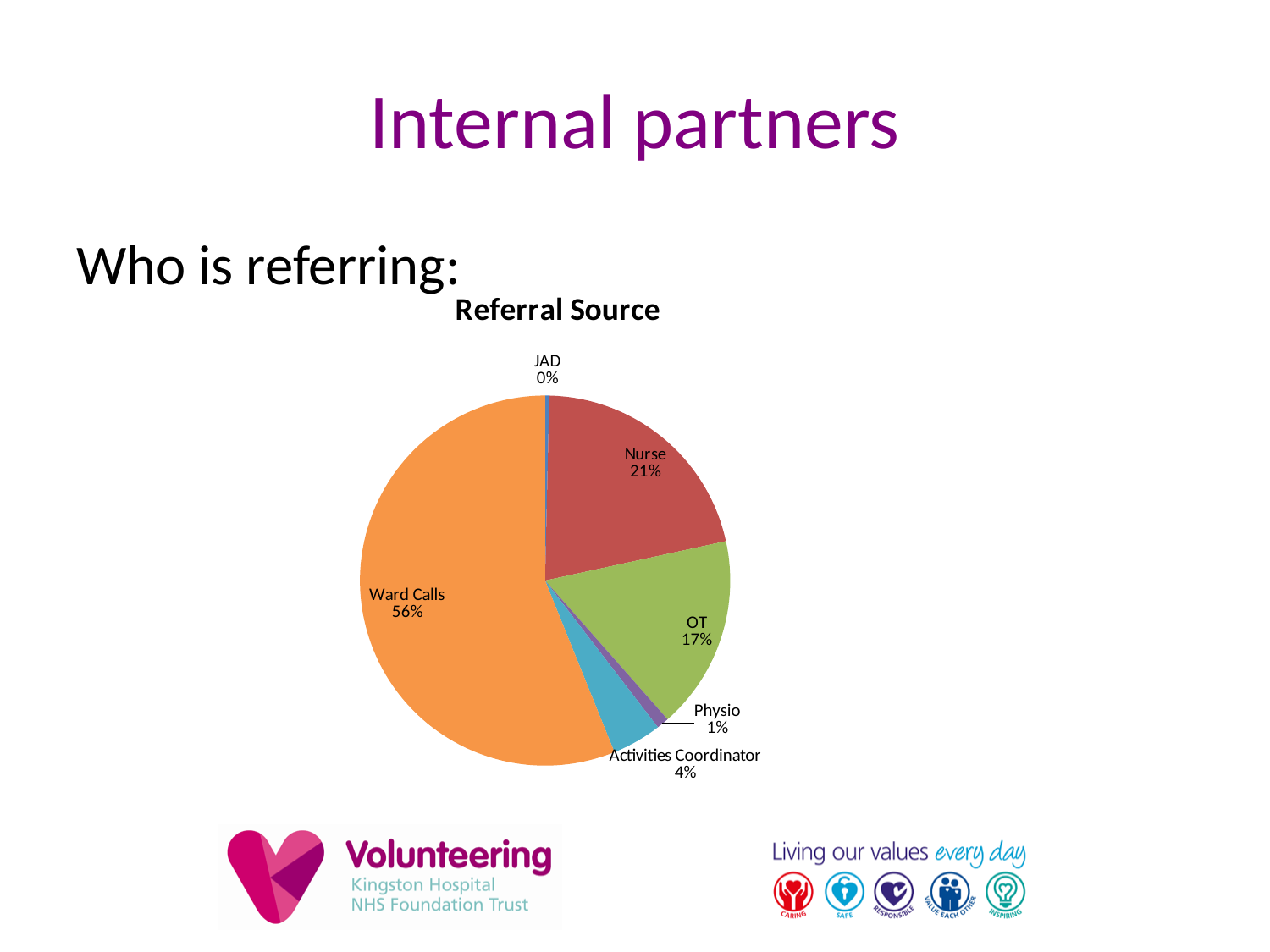
What share of referrals comes from Nurse? 21% What share of referrals comes from Physio? 1% What is the title of the chart? Referral Source Which referral source has the largest share? Ward Calls What share of referrals comes from OT? 17% Which referral source has the smallest share? JAD What type of chart is shown on the slide? pie chart How many referral sources are shown in the pie chart? 6 What share of referrals comes from Activities Coordinator? 4% What share of referrals comes from Ward Calls? 56% What is the difference between the Nurse share and the OT share? 4% Which has a larger share, Nurse or Activities Coordinator? Nurse